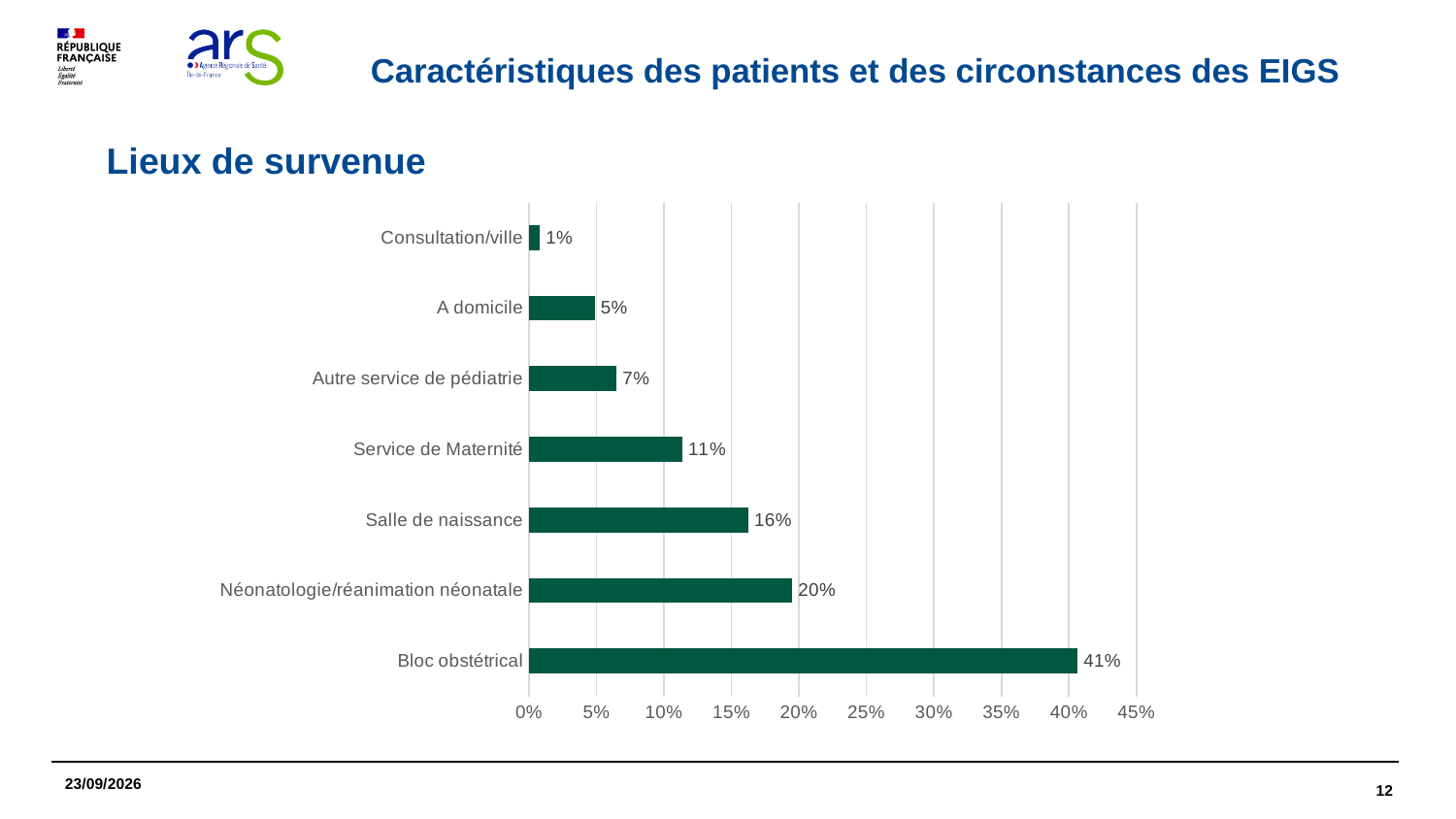
What is the difference between the values for Bloc obstétrical and Néonatologie/réanimation néonatale? 21% Which category has the lowest value? Consultation/ville Which category has the highest value? Bloc obstétrical What kind of chart is shown on the slide? Bar chart What is the maximum value shown on the horizontal axis? 45% What is the value for Bloc obstétrical? 41% Is the value for Néonatologie/réanimation néonatale greater or less than 15%? greater Which is larger, the value for A domicile or the value for Autre service de pédiatrie? Autre service de pédiatrie What is the title of the chart section on the slide? Lieux de survenue How many categories are shown in the chart? 7 What is the value for Service de Maternité? 11% What is the value for Salle de naissance? 16%